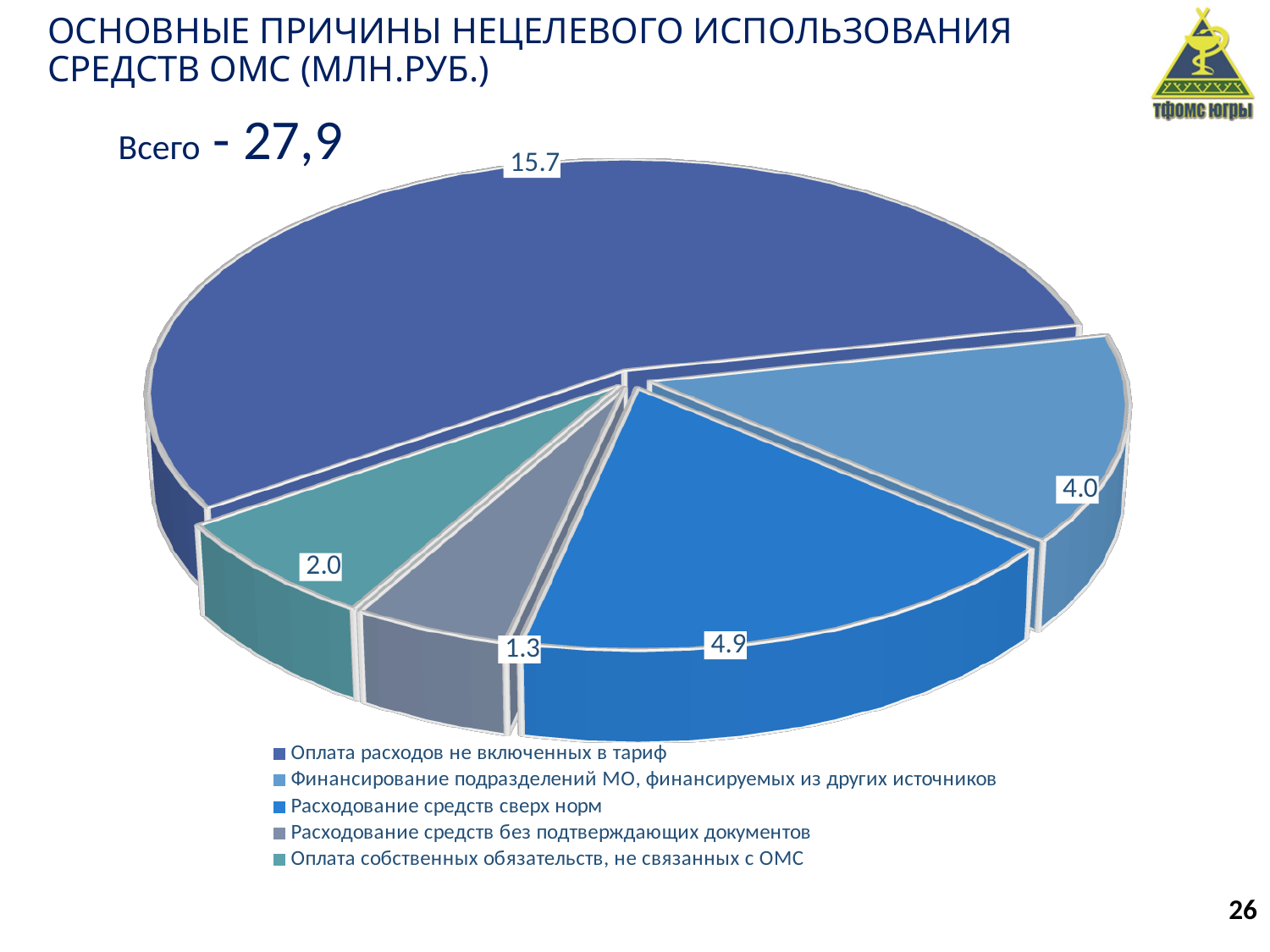
What is the value for 'Оплата собственных обязательств, не связанных с ОМС'? 2.0 What type of chart is shown on the slide? Pie chart Which category has the smallest slice of the pie? Расходование средств без подтверждающих документов What is the value for 'Расходование средств без подтверждающих документов'? 1.3 What total (Всего) is stated on the slide? 27,9 What is the value for 'Финансирование подразделений МО, финансируемых из других источников'? 4.0 What is the value for 'Оплата расходов не включенных в тариф'? 15.7 Which is larger: 'Расходование средств сверх норм' or 'Финансирование подразделений МО, финансируемых из других источников'? Расходование средств сверх норм What is the difference between the values for 'Оплата расходов не включенных в тариф' and 'Расходование средств сверх норм'? 10.8 What is the value for 'Расходование средств сверх норм'? 4.9 How many slices does the pie chart have? 5 Which category has the largest slice of the pie? Оплата расходов не включенных в тариф